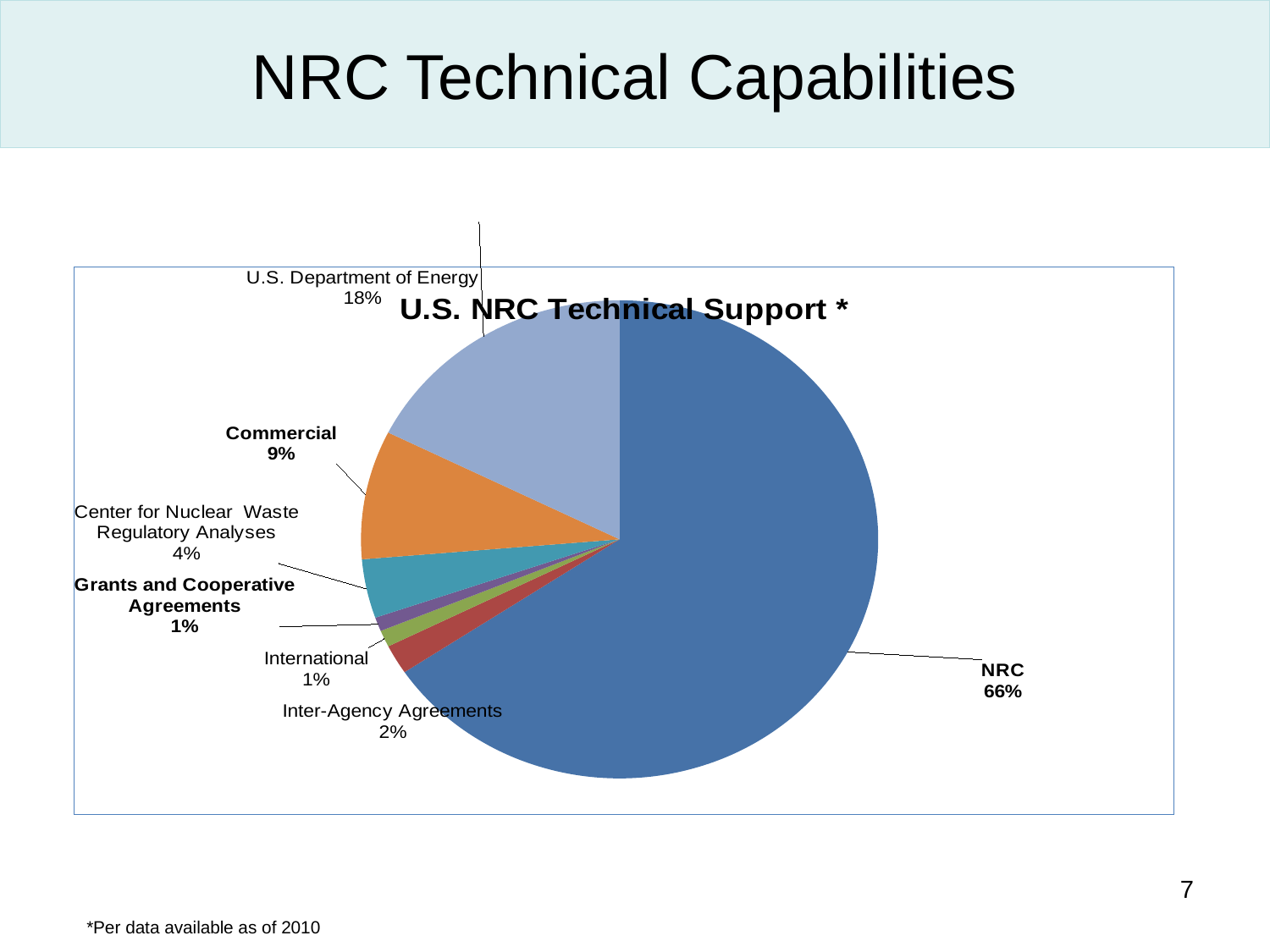
What share of the pie does the U.S. Department of Energy account for? 18% What share of the pie does NRC account for? 66% Which category has the largest share of the pie? NRC What is the difference between the NRC share and the U.S. Department of Energy share? 48% What is the title of the chart? U.S. NRC Technical Support * What is the value for Commercial? 9% What type of chart is shown on the slide? pie chart Which is larger, the share for Commercial or the share for Center for Nuclear Waste Regulatory Analyses? Commercial What is the value for Center for Nuclear Waste Regulatory Analyses? 4% What is the combined share of Commercial and U.S. Department of Energy? 27% How many slices does the pie chart have? 7 What is the value for Inter-Agency Agreements? 2%